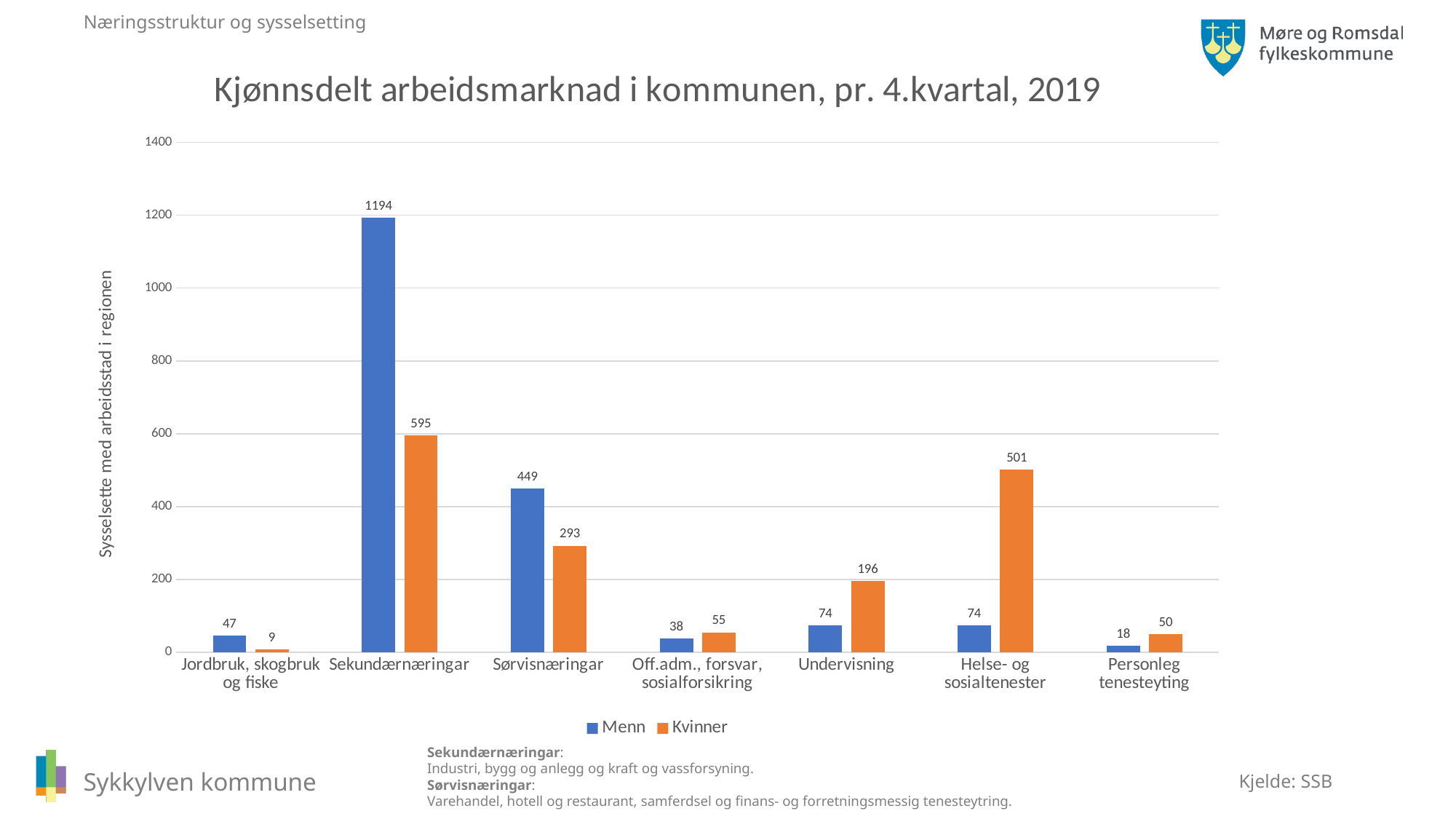
What is the difference between Menn and Kvinner in Sørvisnæringar? 156 How many categories are shown on the x axis? 7 What kind of chart is shown on the slide? Bar chart Is the value for Kvinner in Sekundærnæringar greater or less than 400? greater What is the value for Kvinner in Helse- og sosialtenester? 501 Which category has the lowest value for Menn? Personleg tenesteyting What is the title of the chart? Kjønnsdelt arbeidsmarknad i kommunen, pr. 4.kvartal, 2019 Which category has the highest value for Kvinner? Sekundærnæringar What is the value for Kvinner in Jordbruk, skogbruk og fiske? 9 Which is larger in Undervisning, Menn or Kvinner? Kvinner What is the value for Menn in Sekundærnæringar? 1194 How many series does the legend list? 2